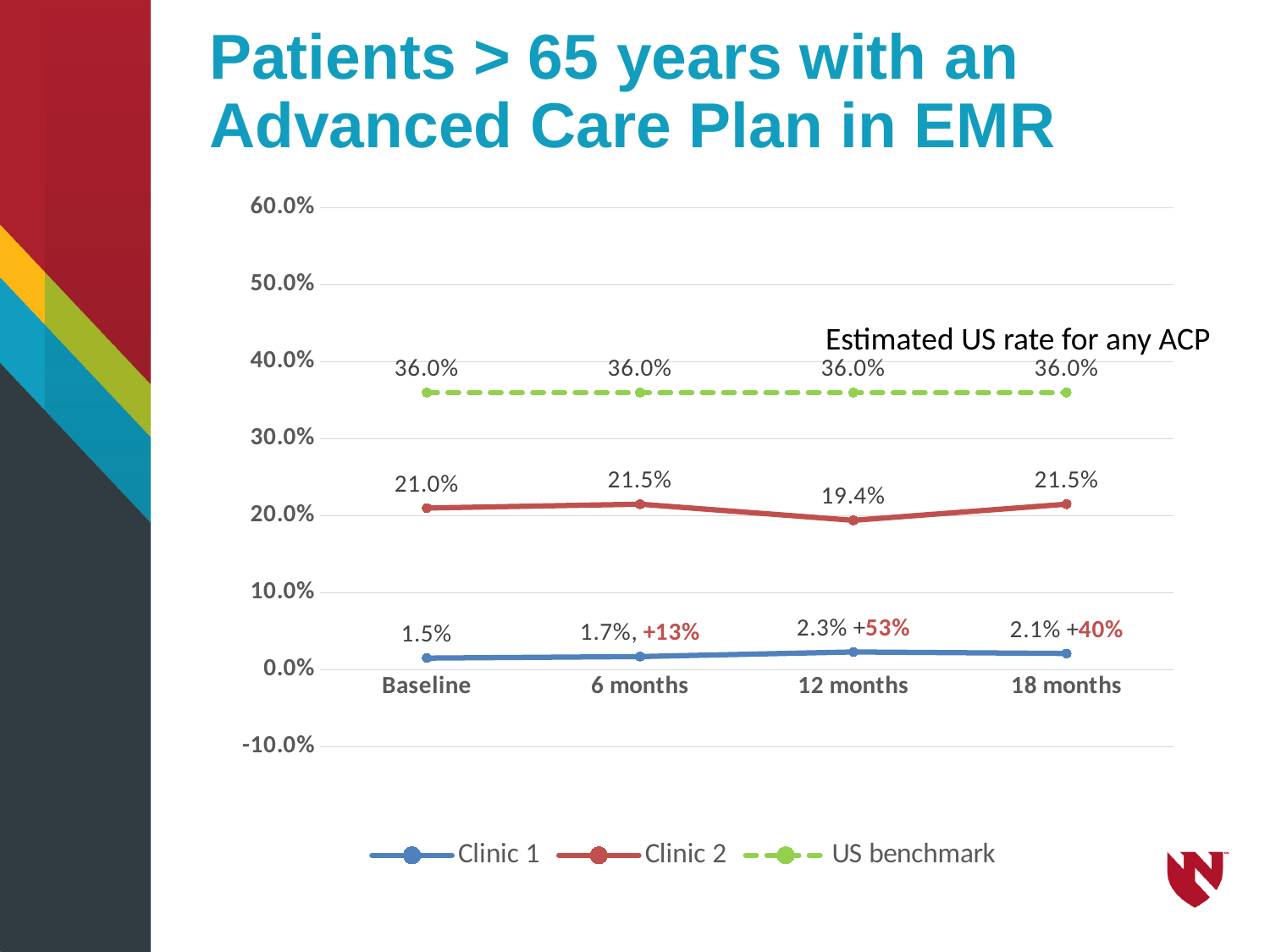
At which time point is Clinic 2 lowest? 12 months What is the value for Clinic 1 at Baseline? 1.5% What is the US benchmark value at 18 months? 36.0% At which time point is Clinic 1 highest? 12 months What is the difference between the US benchmark and Clinic 2 at 18 months? 14.5% Which is larger at 6 months, Clinic 1 or Clinic 2? Clinic 2 What kind of chart is this? Line chart How many series does the legend list? 3 What is the difference between Clinic 2 and Clinic 1 at Baseline? 19.5% What is the value for Clinic 1 at 12 months? 2.3% How many time points are shown on the x axis? 4 What is the value for Clinic 2 at 12 months? 19.4%